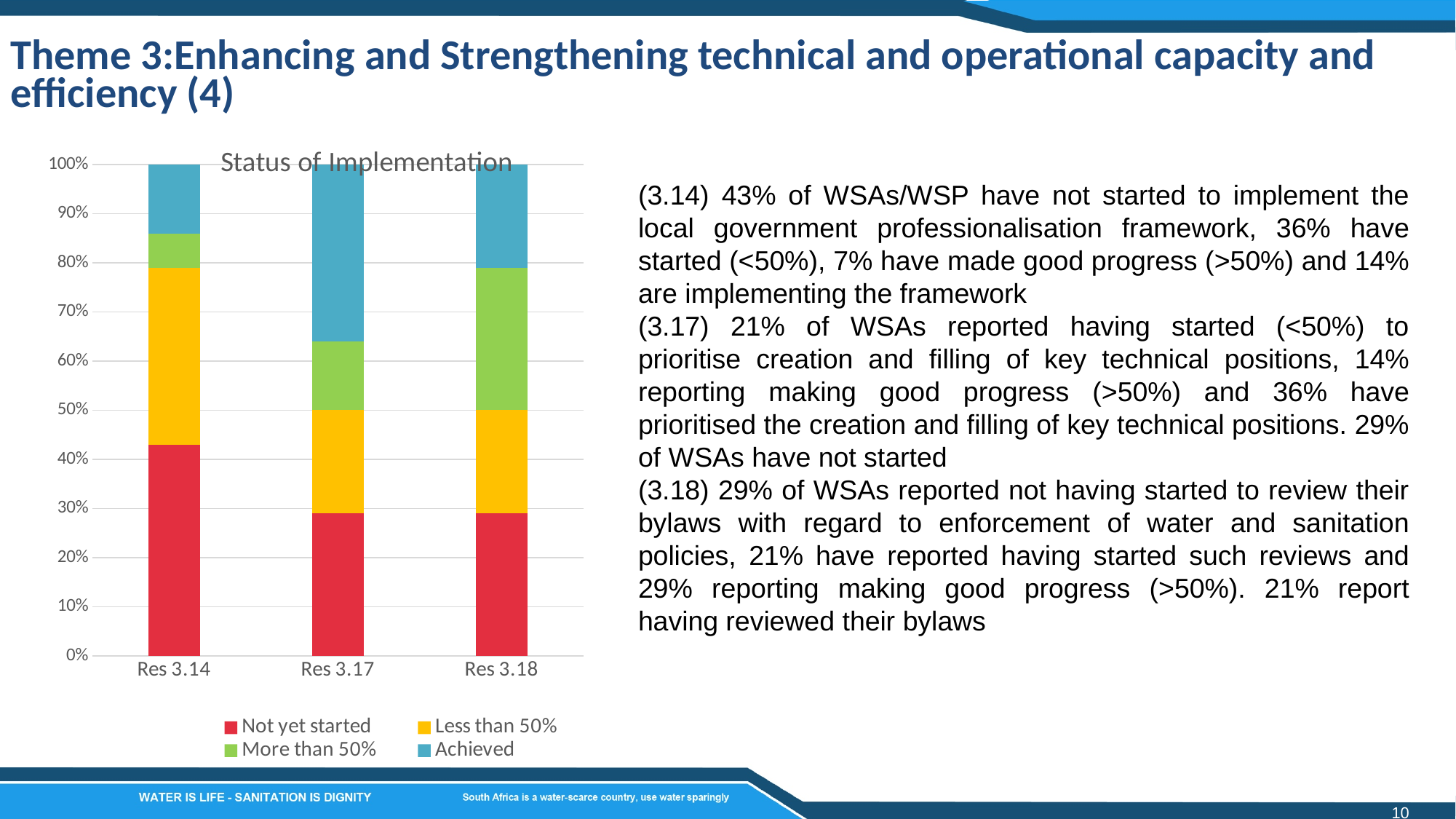
Which series is shown in red in the chart? Not yet started What is the title of the chart? Status of Implementation How many categories are shown on the x axis of the chart? 3 How many series does the chart legend list? 4 What kind of chart is shown on the slide? Stacked bar chart Which has the larger 'More than 50%' segment, Res 3.14 or Res 3.18? Res 3.18 Is the 'Not yet started' value for Res 3.17 greater or less than 40%? less Which has the larger 'Achieved' segment, Res 3.14 or Res 3.17? Res 3.17 Is the 'Not yet started' value for Res 3.14 greater or less than 40%? greater Which category has the largest 'Not yet started' segment? Res 3.14 Is the 'Achieved' value for Res 3.17 greater or less than 30%? greater What is the total of the stacked bar for Res 3.14? 100%